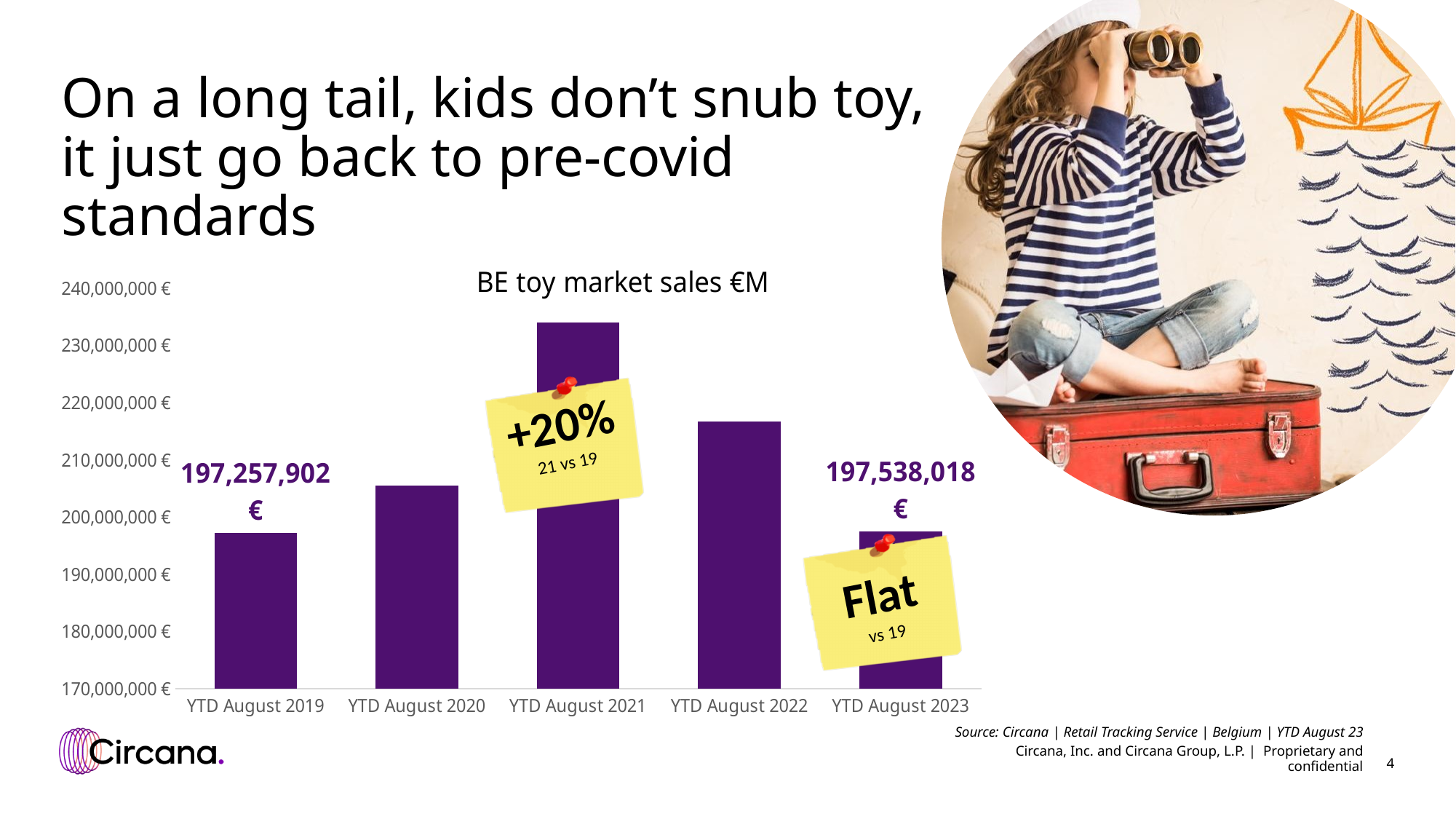
What kind of chart is shown? bar chart Which category has the highest value? YTD August 2021 What is the difference between the values for YTD August 2023 and YTD August 2019? 280,116 € What is the value for YTD August 2023? 197,538,018 € How many categories are shown on the x axis? 5 Do the values rise or fall from YTD August 2021 to YTD August 2023? fall What is the title of the chart? BE toy market sales €M Is the value for YTD August 2020 greater or less than 200,000,000 €? greater Is the value for YTD August 2022 greater or less than 220,000,000 €? less Is the value for YTD August 2021 greater or less than 230,000,000 €? greater Which is larger, the value for YTD August 2021 or the value for YTD August 2022? YTD August 2021 What is the value for YTD August 2019? 197,257,902 €